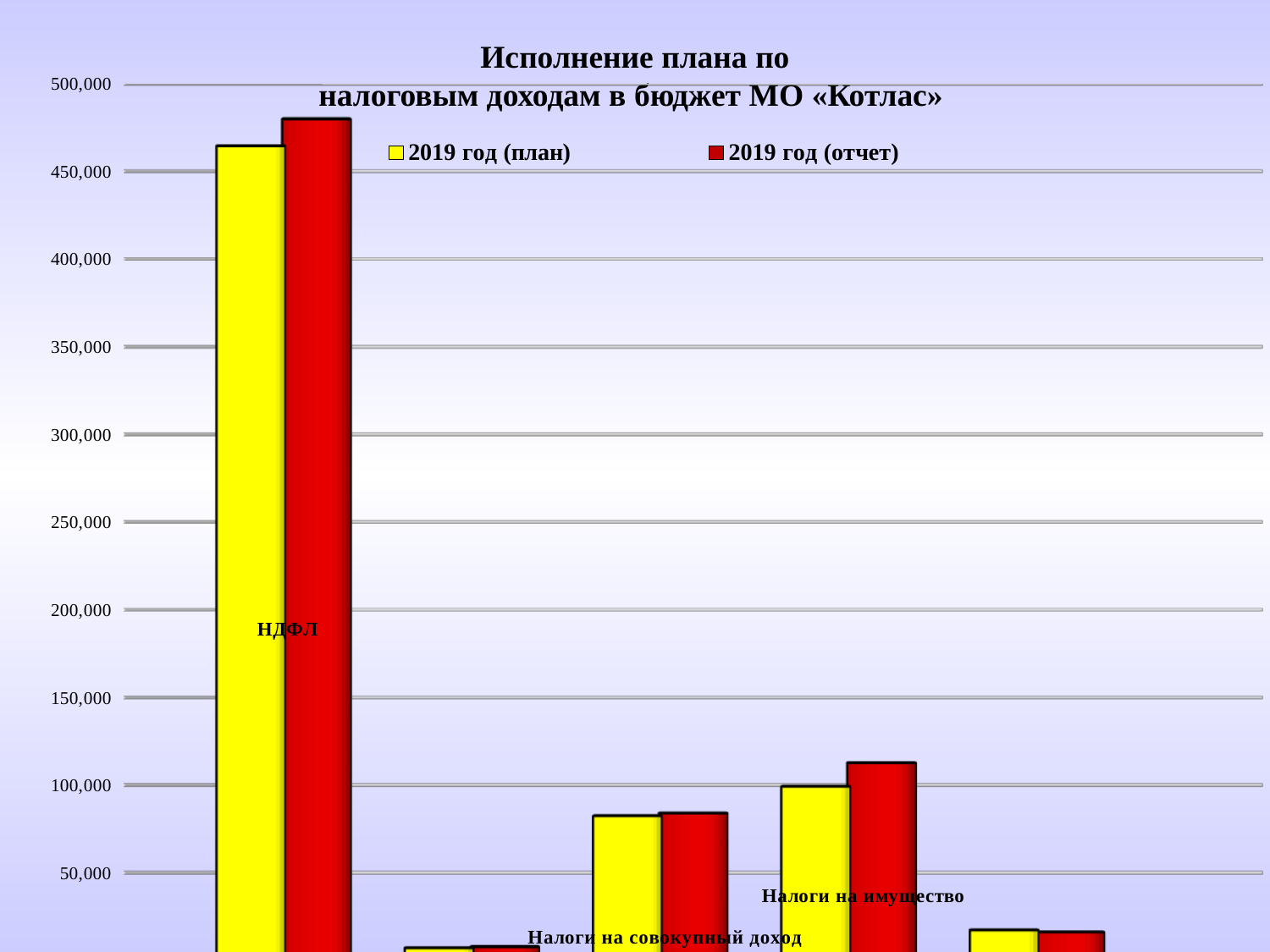
Is the 2019 год (отчет) value for НДФЛ greater or less than 500,000? less Which category has the highest values in the chart? НДФЛ What is the title of the chart? Исполнение плана по налоговым доходам в бюджет МО «Котлас» Is the 2019 год (отчет) value for Налоги на совокупный доход greater or less than 50,000? greater Is the 2019 год (план) value for Налоги на совокупный доход greater or less than 100,000? less What kind of chart is shown on the slide? bar chart What colour are the bars for the 2019 год (отчет) series? red How many series does the legend list? 2 For НДФЛ, which is larger: the 2019 год (план) value or the 2019 год (отчет) value? 2019 год (отчет) For Налоги на имущество, which is larger: the 2019 год (план) value or the 2019 год (отчет) value? 2019 год (отчет)